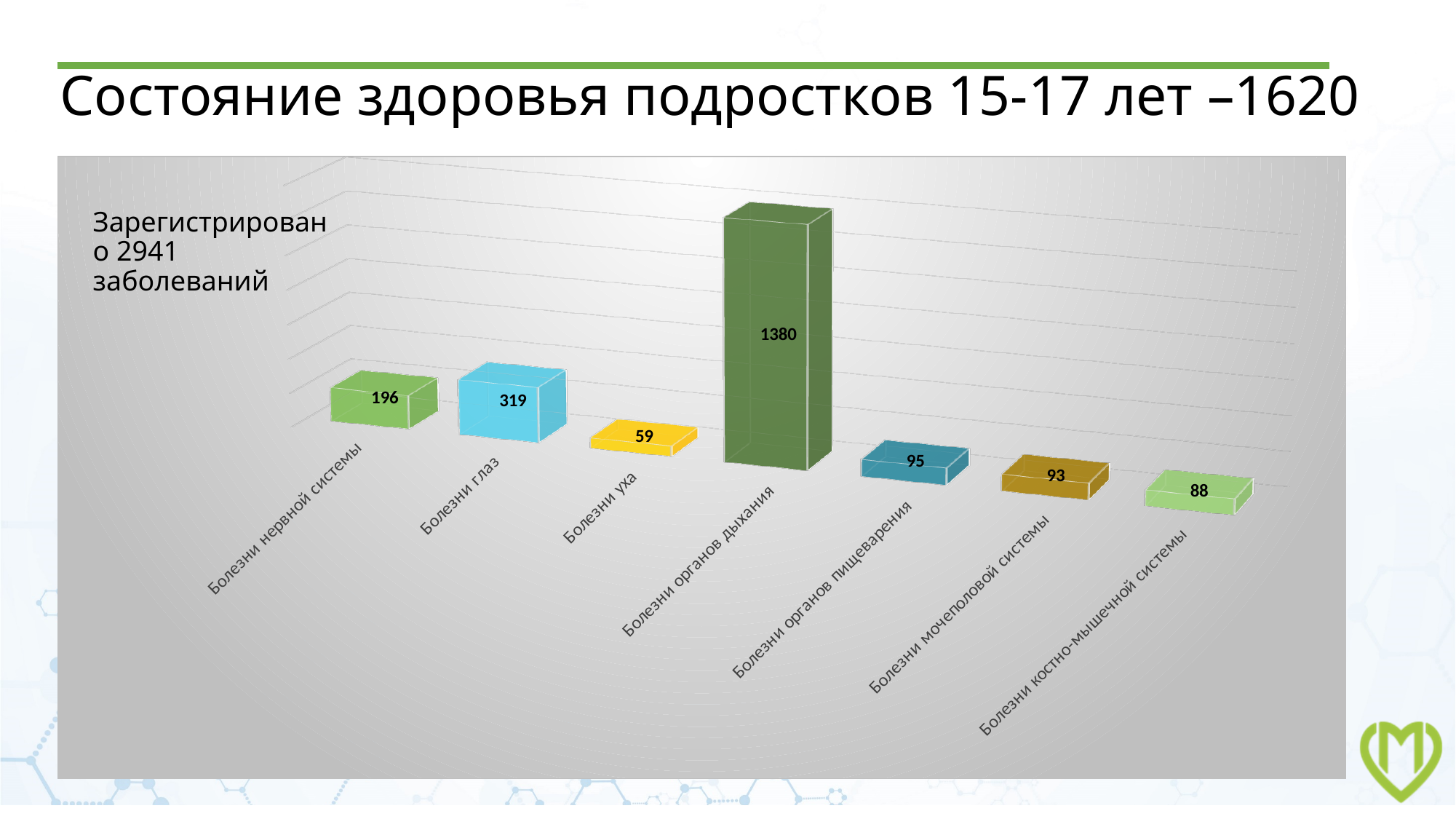
What is the difference between the values for Болезни органов пищеварения and Болезни мочеполовой системы? 2 What kind of chart is shown on the slide? Bar chart How many categories are shown in the chart? 7 What is the value for Болезни нервной системы? 196 What is the difference between the values for Болезни глаз and Болезни нервной системы? 123 Which category has the highest value? Болезни органов дыхания Which is larger, the value for Болезни нервной системы or the value for Болезни уха? Болезни нервной системы What is the value for Болезни органов дыхания? 1380 What is the value for Болезни глаз? 319 What number of registered diseases is stated in the text inside the chart area? 2941 What is the value for Болезни костно-мышечной системы? 88 Which category has the lowest value? Болезни уха